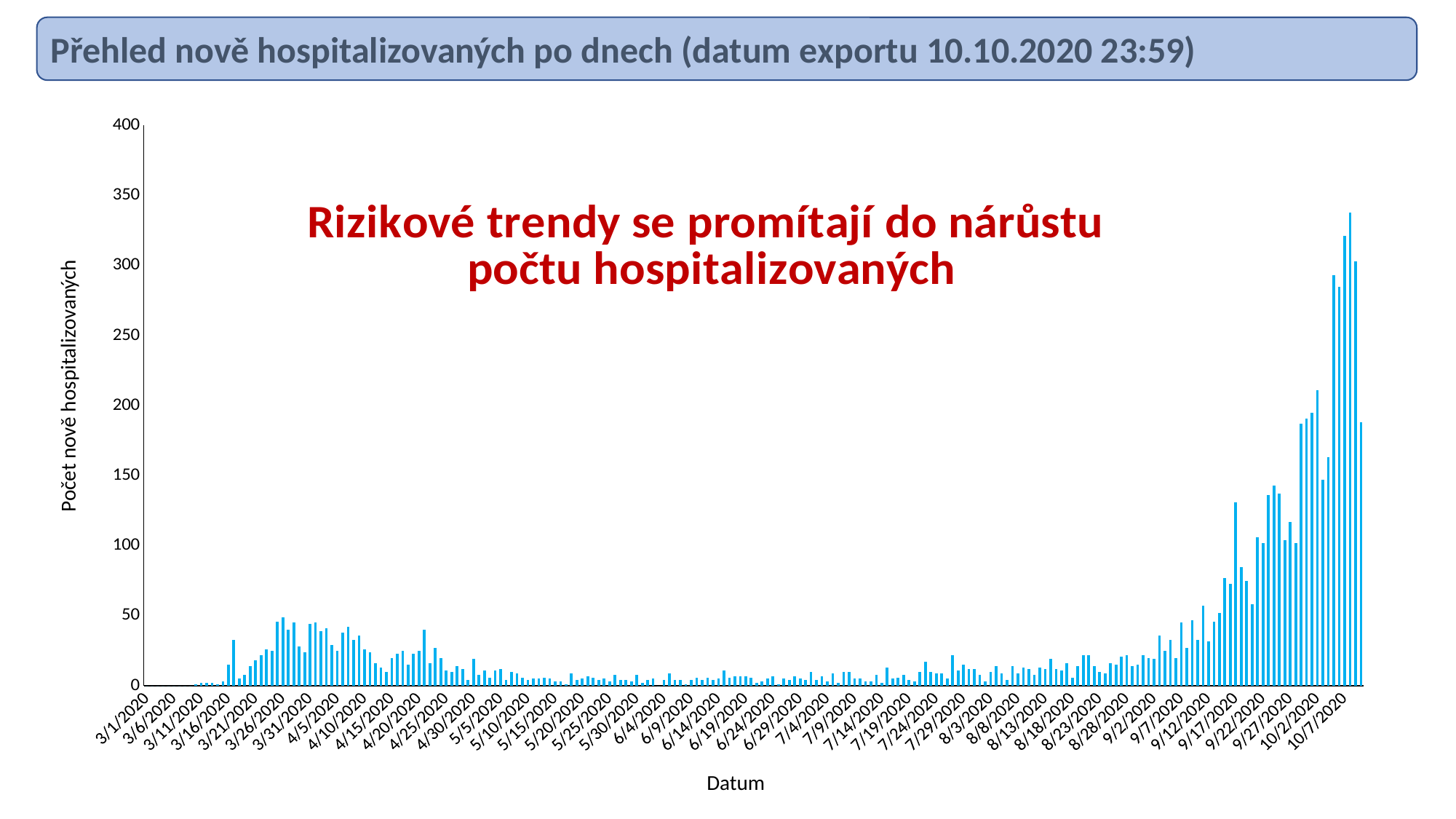
Is the tallest bar in the chart greater or less than 300? greater In which month does the highest daily value occur? October 2020 Do the values generally rise or fall from 9/2/2020 to 10/7/2020? rise Which is larger, the value for 10/7/2020 or the value for 3/26/2020? 10/7/2020 Is the value for 9/17/2020 greater or less than 200? less Is the value for 3/26/2020 greater or less than 100? less Do the values generally rise or fall from 3/31/2020 to 5/30/2020? fall What is the title of the chart on the slide? Přehled nově hospitalizovaných po dnech (datum exportu 10.10.2020 23:59) What kind of chart is shown on the slide? Bar chart What is the label of the vertical axis? Počet nově hospitalizovaných